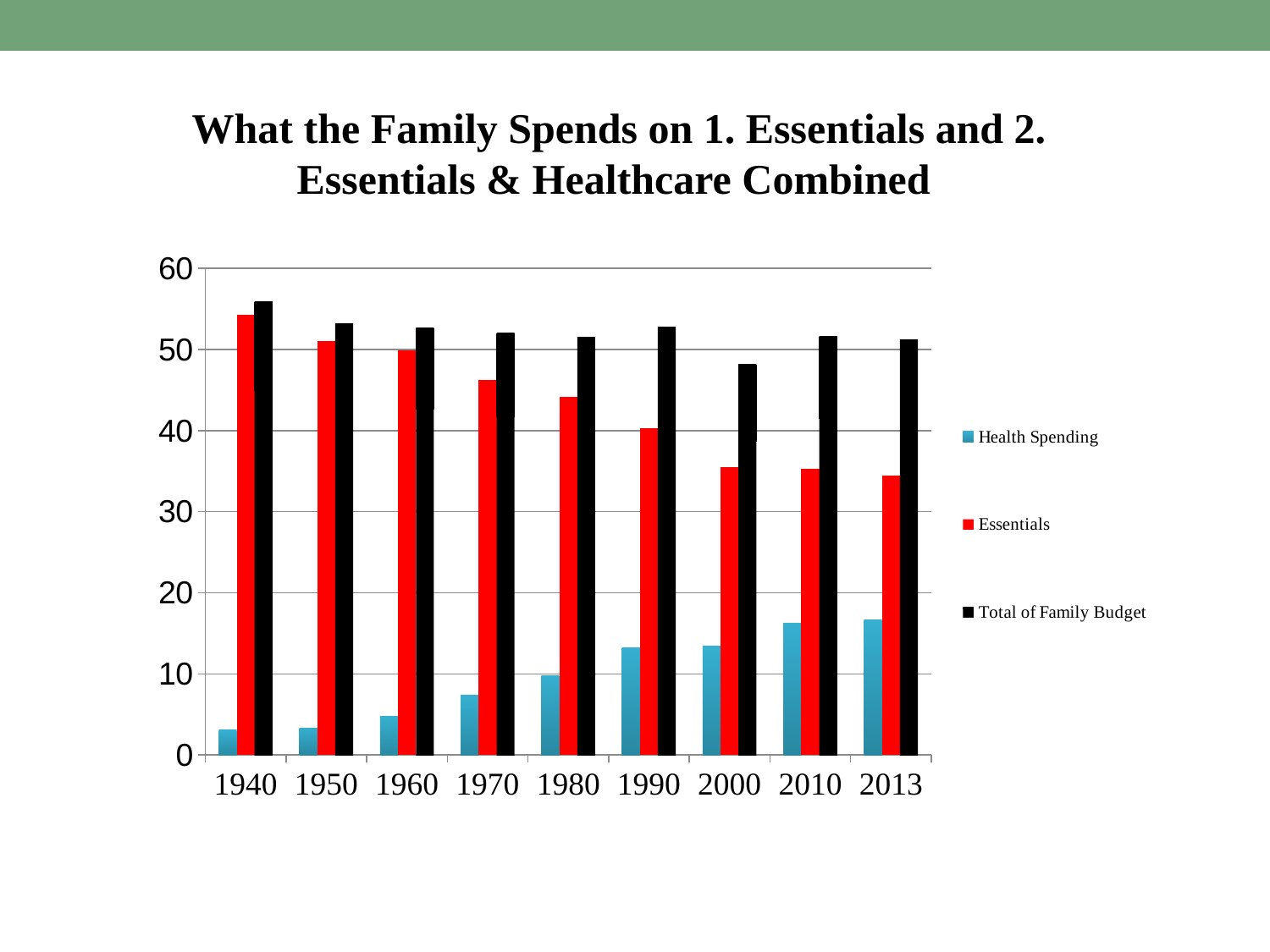
Does Health Spending rise or fall from 1940 to 2013? Rises Which is larger: Health Spending in 1940 or Health Spending in 2013? 2013 Is the Essentials value for 1940 greater or less than 50? greater In which year is the Total of Family Budget value lowest? 2000 Is the Essentials value for 1970 greater or less than 50? less How many series does the legend list? 3 Is the Total of Family Budget value for 2000 greater or less than 50? less Which colour represents Essentials in the legend? Red In which year is the Essentials value highest? 1940 What kind of chart is shown on the slide? Bar chart How many years are shown on the x axis? 9